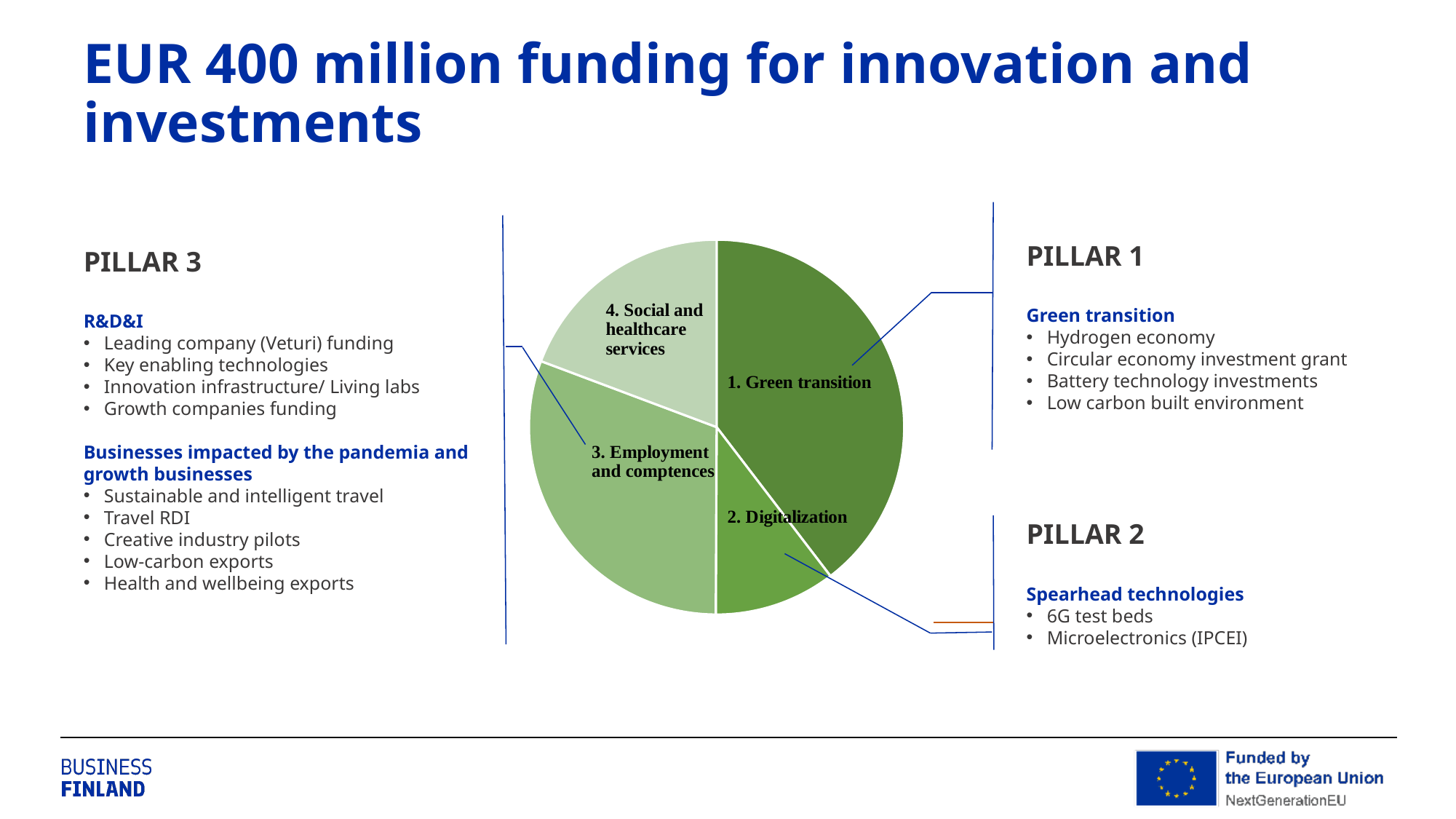
Which slice of the pie chart is shaded the darkest green? 1. Green transition What kind of chart is shown on the slide? Pie chart Which slice is larger: 3. Employment and comptences or 4. Social and healthcare services? 3. Employment and comptences Which slice is larger: 1. Green transition or 4. Social and healthcare services? 1. Green transition Which slice of the pie chart is shaded the lightest green? 4. Social and healthcare services Which slice is larger: 3. Employment and comptences or 2. Digitalization? 3. Employment and comptences Which slice of the pie chart is the largest? 1. Green transition How many slices does the pie chart have? 4 Which slice of the pie chart is the smallest? 2. Digitalization